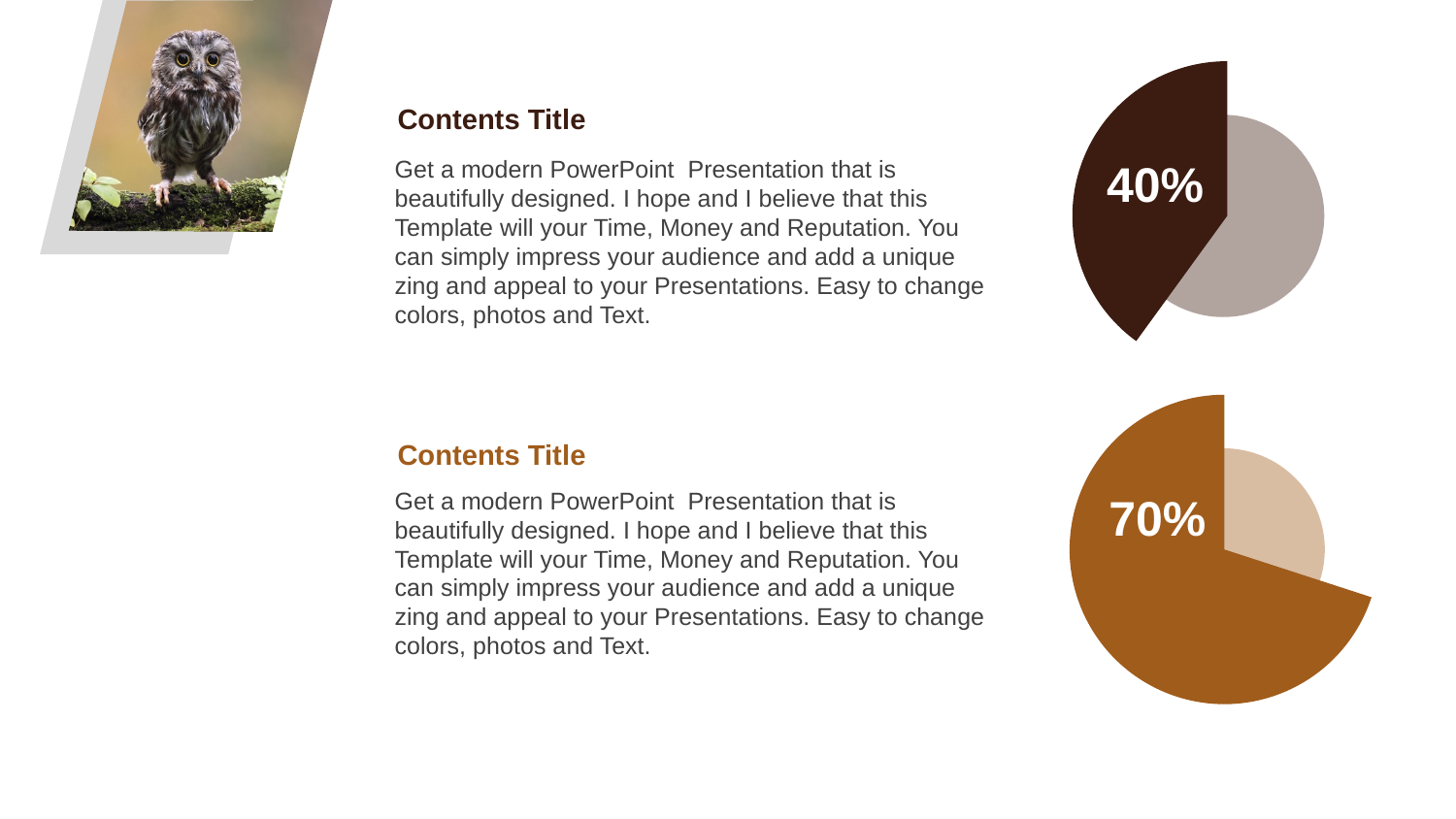
What percentage is shown on the bottom pie chart? 70% Which pie chart shows the larger percentage, the top one or the bottom one? The bottom one What kind of chart is used on the right side of the slide? Pie chart Is the value shown on the bottom pie chart greater or less than 50%? greater What share of the bottom pie chart does the orange-brown slice represent? 70% What colour is the highlighted slice of the top pie chart? Dark brown What percentage is shown on the top pie chart? 40% Is the value shown on the top pie chart greater or less than 50%? less What share of the top pie chart does the dark brown slice represent? 40% What is the heading of the text block next to the bottom pie chart? Contents Title What is the difference between the percentage on the bottom pie chart and the percentage on the top pie chart? 30% How many pie charts are on the slide? 2